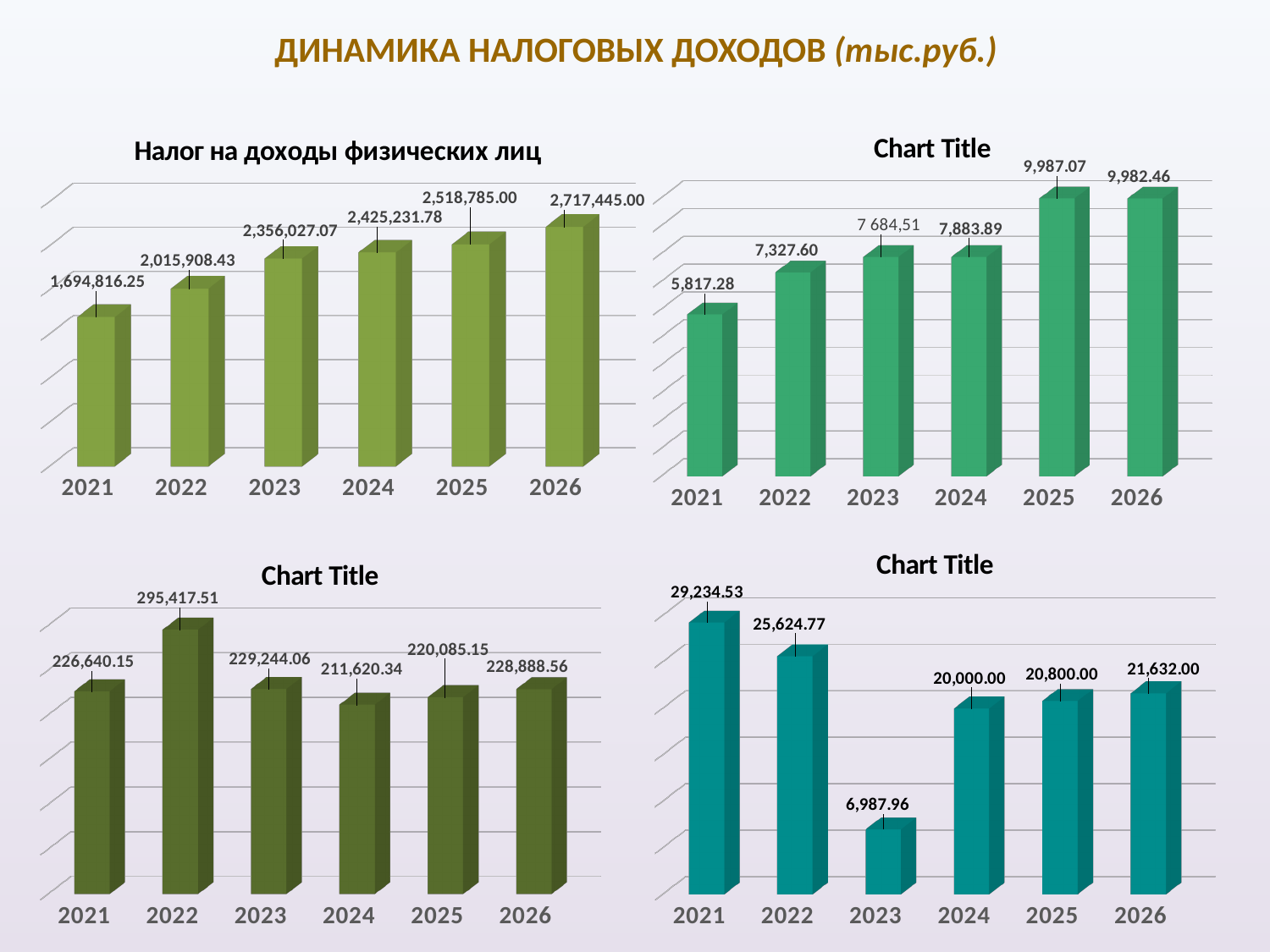
In the top-right chart, which year has the highest value? 2025 In the top-left chart titled 'Налог на доходы физических лиц', what is the difference between the 2026 and 2025 values? 198,660.00 What kind of chart is the bottom-right chart? bar chart In the top-right chart, what is the value for 2022? 7,327.60 In the top-left chart titled 'Налог на доходы физических лиц', what is the value for 2023? 2,356,027.07 In the top-right chart, how many years are shown on the x axis? 6 In the top-left chart titled 'Налог на доходы физических лиц', which year has the lowest value? 2021 In the bottom-right chart, which year has the lowest value? 2023 In the bottom-right chart, which is larger, the value for 2021 or the value for 2022? 2021 In the top-left chart titled 'Налог на доходы физических лиц', do the values rise or fall from 2021 to 2026? rise In the bottom-left chart, what is the value for 2024? 211,620.34 In the bottom-left chart, which year has the highest value? 2022